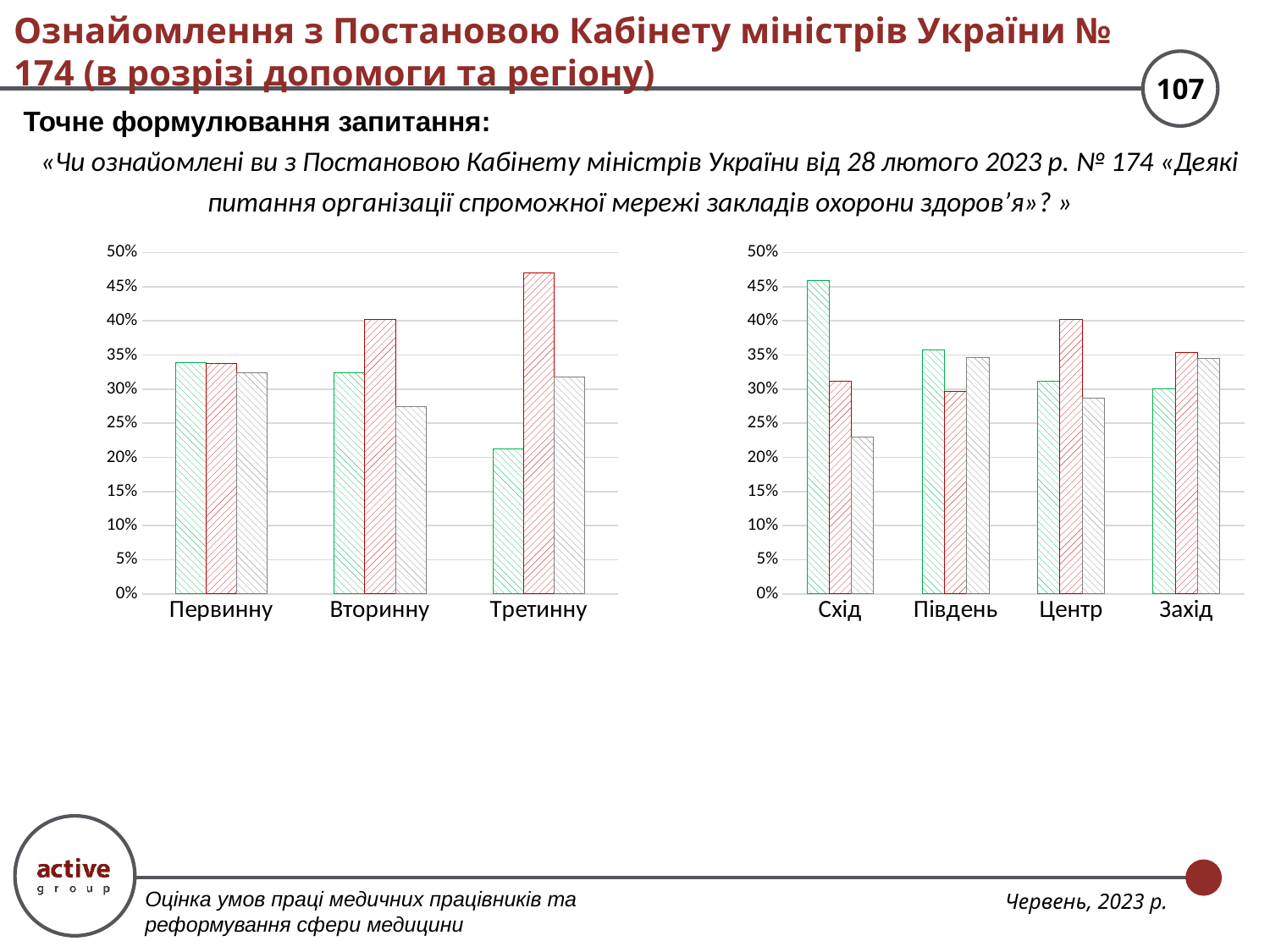
In the right chart, how many bars are shown for each region? 3 What kind of chart is the left chart (Первинну, Вторинну, Третинну)? bar chart In the left chart, which category contains the tallest bar? Третинну In the right chart, is the grey hatched bar for Схід greater or less than 25%? less How many categories are shown on the x axis of the left chart? 3 In the right chart, for Центр, which is larger: the red hatched bar or the grey hatched bar? the red hatched bar In the right chart, is the green hatched bar for Схід greater or less than 40%? greater In the left chart, is the green hatched bar for Третинну greater or less than 25%? less How many categories are shown on the x axis of the right chart? 4 In the left chart, for Третинну, which is larger: the red hatched bar or the green hatched bar? the red hatched bar